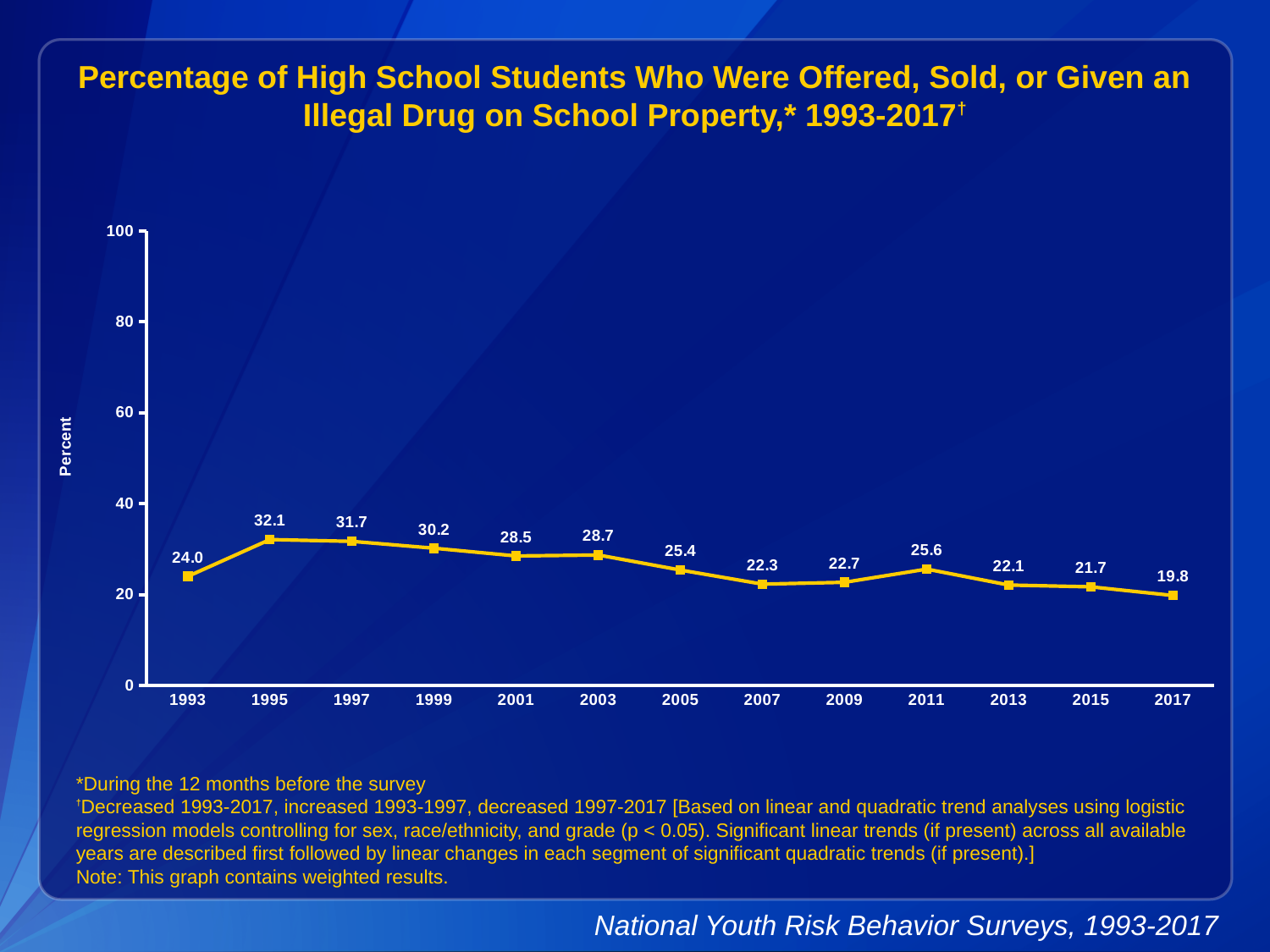
How many years are plotted on the x axis? 13 Which year has the highest percentage? 1995 What is the label on the y axis? Percent Which year has the lowest percentage? 2017 What value is shown for 2011? 25.6 Do the values generally rise or fall from 1997 to 2017? fall What is the difference between the 1995 value and the 2017 value? 12.3 What kind of chart is shown on the slide? line chart What was the percentage of high school students offered, sold, or given an illegal drug on school property in 1993? 24.0 What value is shown for 2017? 19.8 Which year has a higher value, 2003 or 2005? 2003 Is the value for 1997 greater or less than 40? less